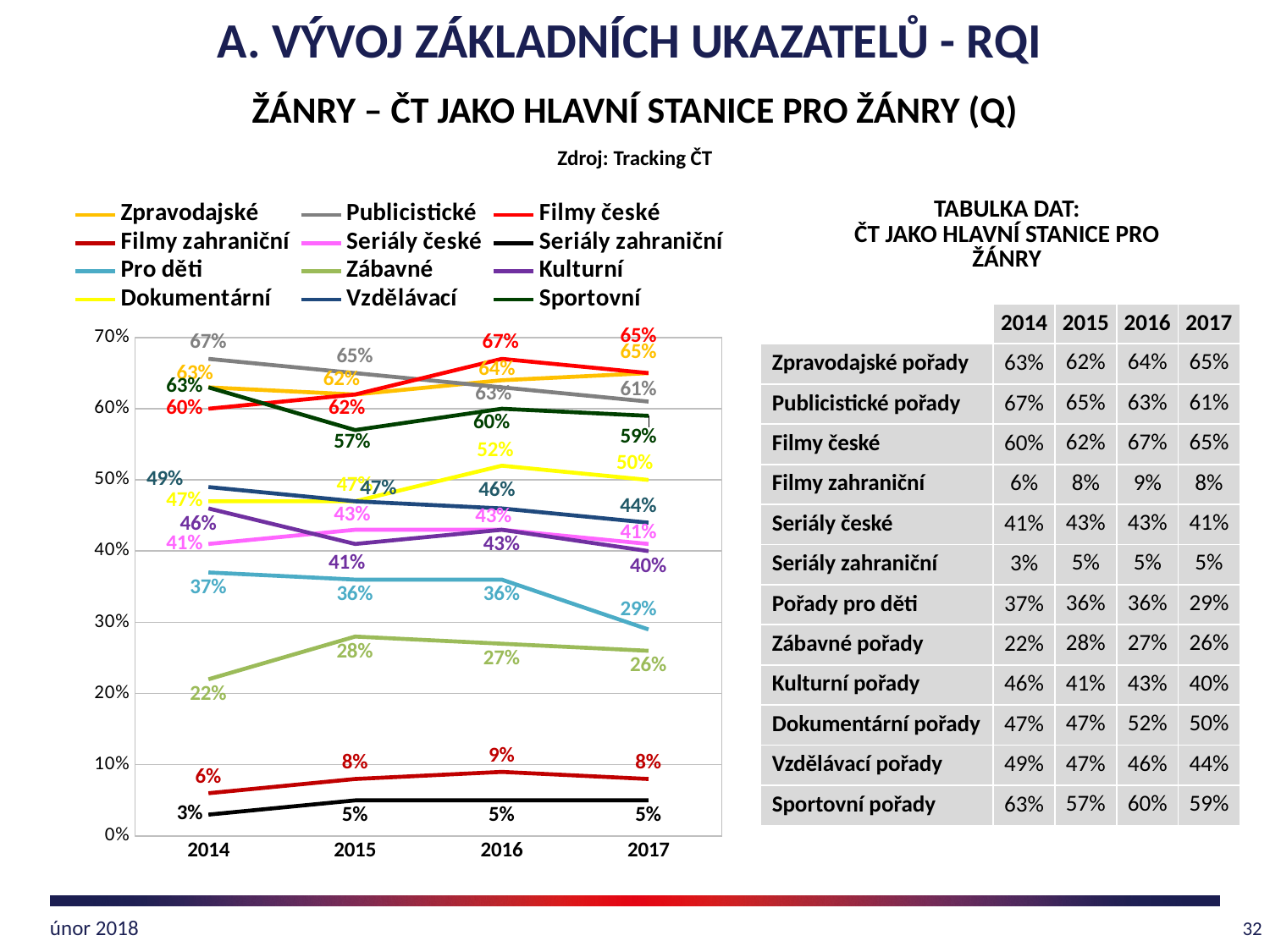
What source is cited for the chart data? Tracking ČT What is the value for Zábavné in 2014? 22% In 2016, which is larger: Filmy české or Zpravodajské? Filmy české Which series has the highest value in 2014? Publicistické What kind of chart is shown on the slide? line chart What is the value for Dokumentární in 2016? 52% Which series has the lowest value in 2014? Seriály zahraniční By how many percentage points did Publicistické fall from 2014 to 2017? 6 percentage points Does the Publicistické series rise or fall from 2014 to 2017? fall How many years are plotted along the x axis of the chart? 4 What is the value for Pro děti in 2017? 29% How many series does the chart legend list? 12